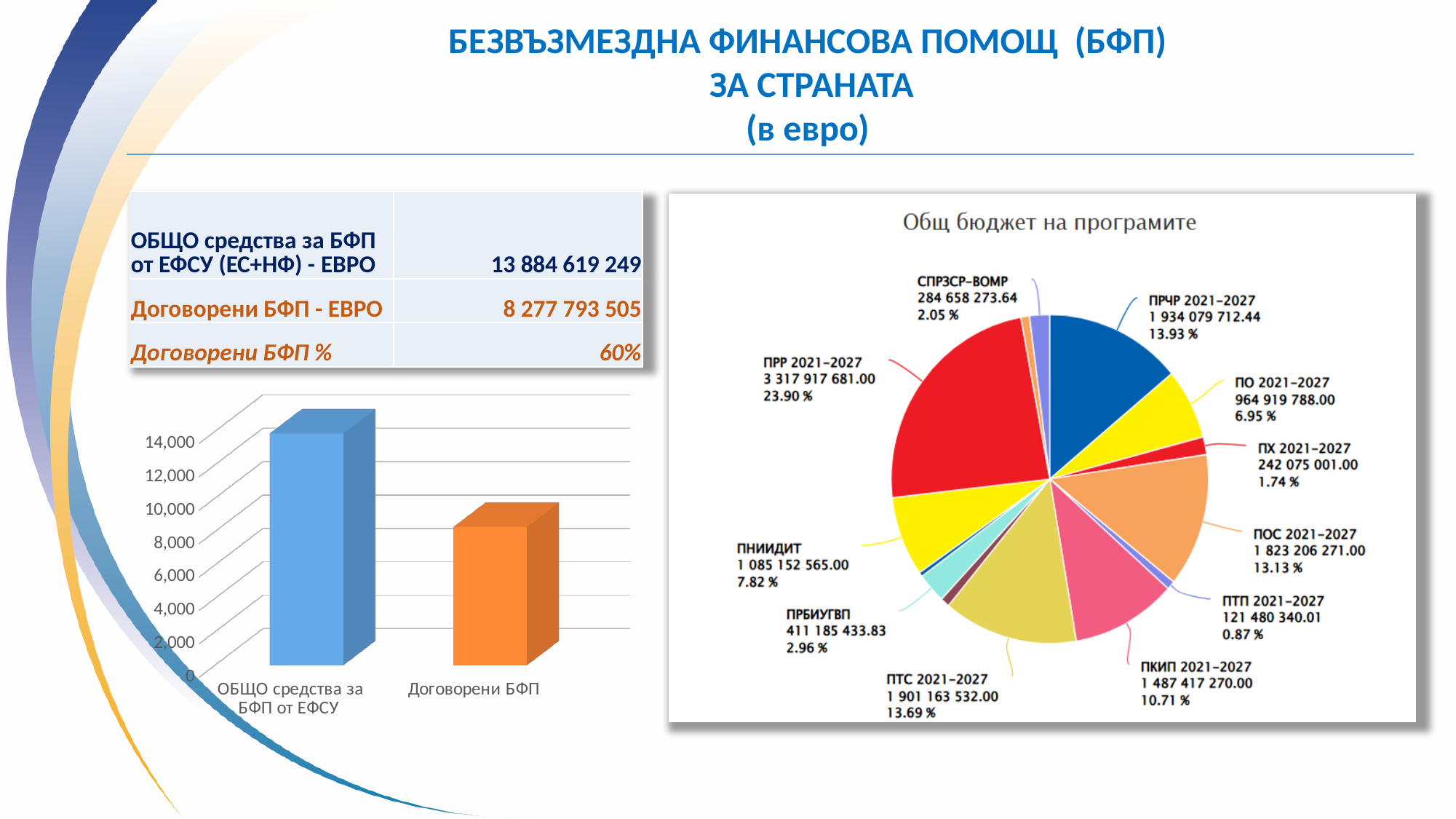
What type of chart is the chart on the left of the slide? bar chart What type of chart is the chart titled "Общ бюджет на програмите"? pie chart In the pie chart "Общ бюджет на програмите", what is the value for ПРР 2021-2027? 3 317 917 681.00 In the bar chart on the left, how many bars are shown? 2 In the bar chart on the left, is the value for "ОБЩО средства за БФП от ЕФСУ" greater or less than 12,000? greater In the pie chart "Общ бюджет на програмите", which programme has the largest slice? ПРР 2021-2027 In the bar chart on the left, is the value for "Договорени БФП" greater or less than 10,000? less In the pie chart "Общ бюджет на програмите", what is the difference in percentage share between ПРЧР 2021-2027 and ПОС 2021-2027? 0.80 % In the bar chart on the left, which bar is taller, "ОБЩО средства за БФП от ЕФСУ" or "Договорени БФП"? ОБЩО средства за БФП от ЕФСУ In the pie chart "Общ бюджет на програмите", what share does ПКИП 2021-2027 have? 10.71 % In the pie chart "Общ бюджет на програмите", which programme has the smallest slice? ПТП 2021-2027